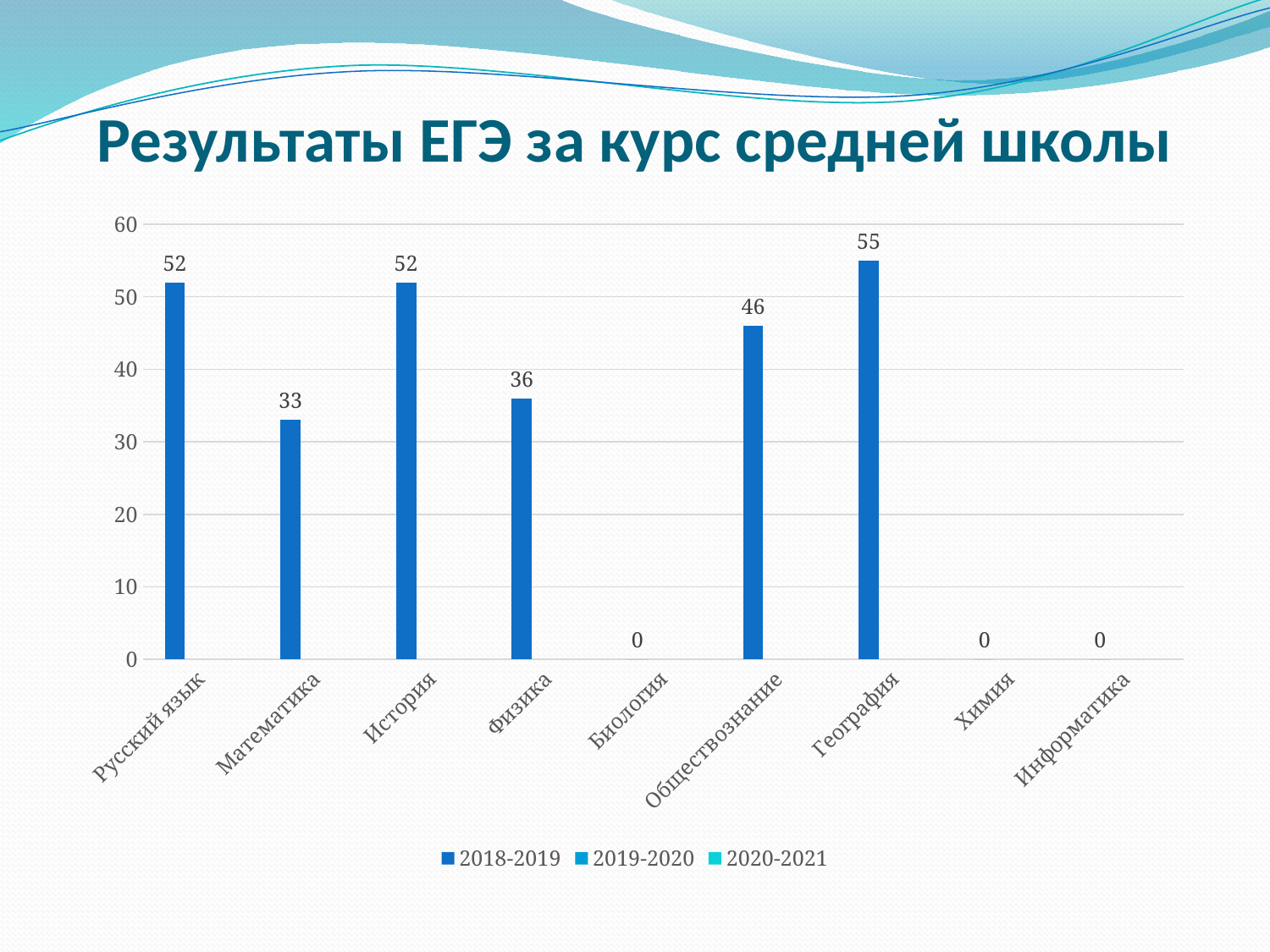
What is the difference between the values for География and Обществознание? 9 Which is larger, the value for Физика or the value for Обществознание? Обществознание Which category has the highest value? География How many series does the legend list? 3 How many categories are shown on the x axis? 9 What is the value for География? 55 What kind of chart is shown on the slide? Bar chart What is the value for Обществознание? 46 What is the value for Математика? 33 What is the value for Физика? 36 What is the title of the chart on the slide? Результаты ЕГЭ за курс средней школы What is the difference between the values for Русский язык and Математика? 19